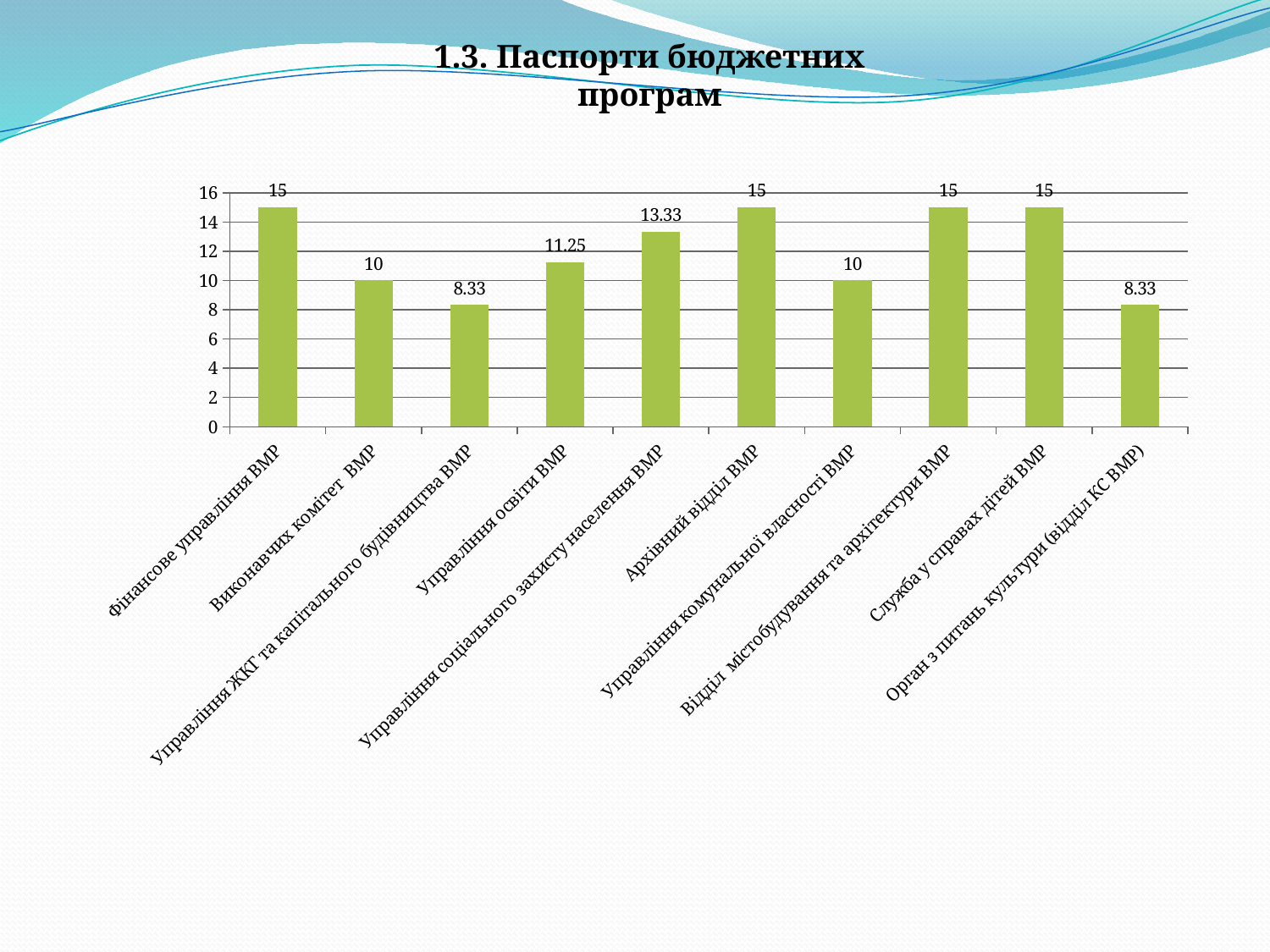
How many categories are shown on the x axis of the chart? 10 What is the value for Виконавчих комітет ВМР? 10 What kind of chart is shown on the slide? bar chart What is the difference between the values for Фінансове управління ВМР and Управління ЖКГ та капітального будівництва ВМР? 6.67 What is the value for Управління соціального захисту населення ВМР? 13.33 Which is larger, the value for Управління освіти ВМР or the value for Управління комунальної власності ВМР? Управління освіти ВМР What is the value for Архівний відділ ВМР? 15 What is the title of the slide containing the chart? 1.3. Паспорти бюджетних програм What is the difference between the values for Управління соціального захисту населення ВМР and Управління освіти ВМР? 2.08 What is the value for Управління освіти ВМР? 11.25 Is the value for Управління соціального захисту населення ВМР greater or less than 12? greater What is the value for Орган з питань культури (відділ КС ВМР)? 8.33